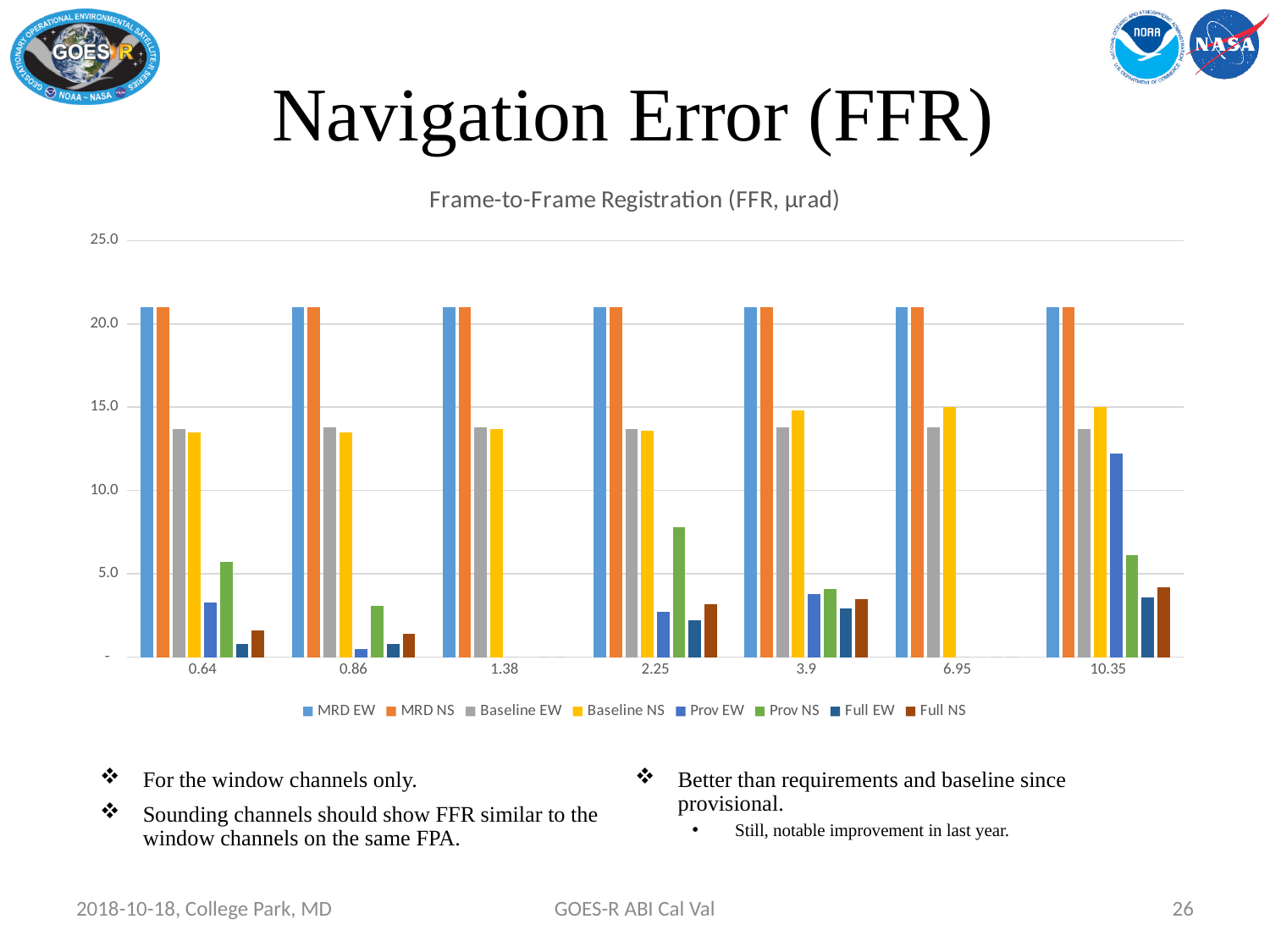
What kind of chart is shown on the slide? bar chart Is the Full NS value for the 0.64 category greater or less than 5.0? less Which category has the larger Prov NS value, 0.86 or 2.25? 2.25 What is the title of the chart? Frame-to-Frame Registration (FFR, μrad) Is the Baseline EW value for the 1.38 category greater or less than 10.0? greater Is the Prov NS value for the 2.25 category greater or less than 5.0? greater How many series does the chart legend list? 8 Which category has the highest Prov EW value? 10.35 How many categories are shown along the x axis of the chart? 7 What colour are the MRD NS bars in the chart? orange